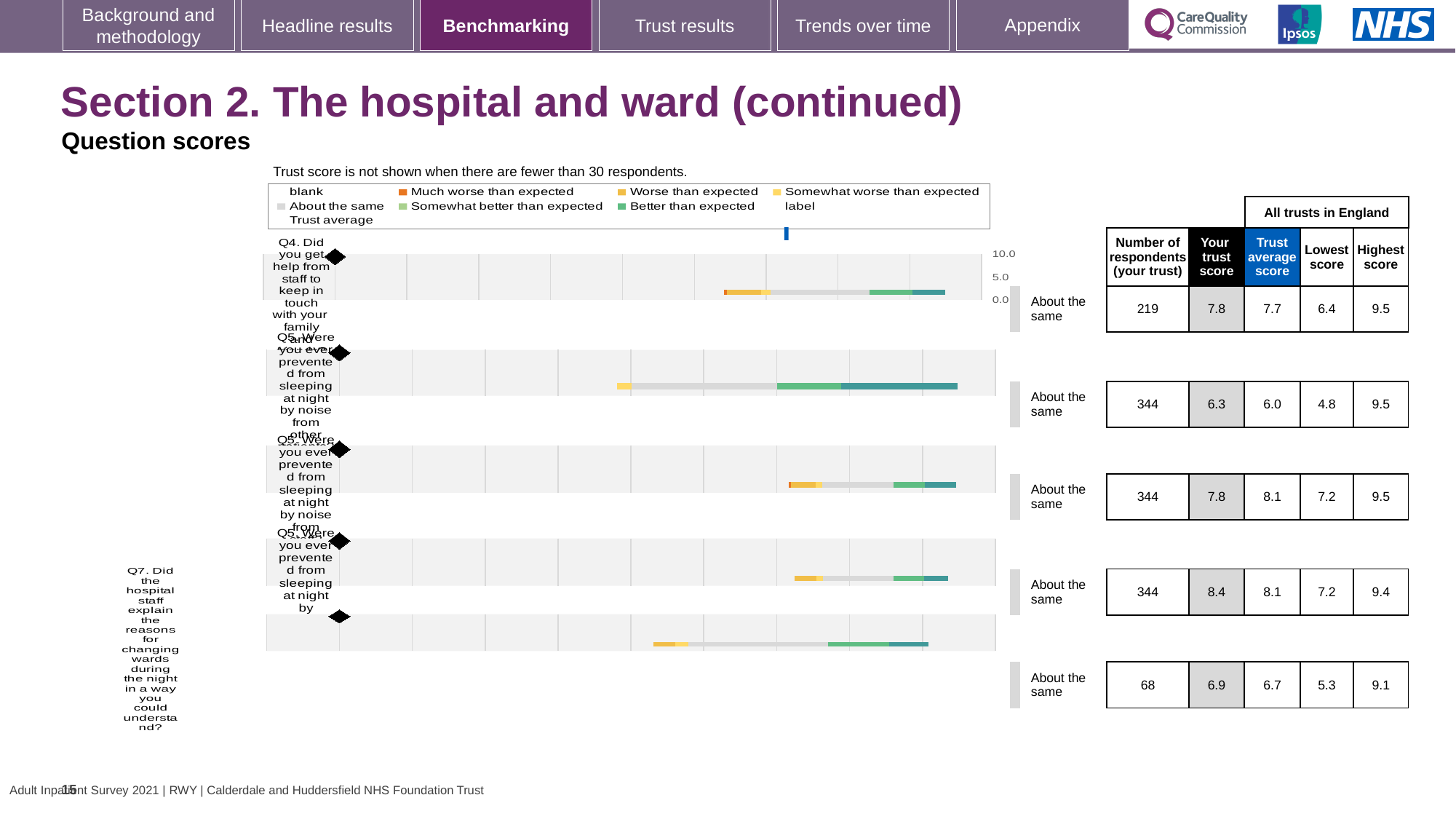
In the table beside the chart, what is the 'Your trust score' for the first row (Q4, help from staff to keep in touch with family)? 7.8 In the table beside the chart, what is the 'Trust average score' for the first row (Q4)? 7.7 In the table beside the chart, what is the 'Lowest score' for the second row (344 respondents, trust score 6.3)? 4.8 What is the smallest number of respondents shown in the table beside the chart? 68 In the table beside the chart, how many respondents are shown for the first row (Q4)? 219 What benchmark category label is shown next to every row of the chart? About the same How many question rows (bars) are plotted in the chart? 5 For the first row (Q4), what is the difference between the 'Your trust score' (7.8) and the 'Trust average score' (7.7)? 0.1 According to the chart legend, what does the orange segment represent? Much worse than expected According to the chart legend, what does the grey segment represent? About the same For the first row (Q4), which is larger: the 'Your trust score' or the 'Trust average score'? Your trust score What kind of chart is used to show the question scores on this slide? bar chart